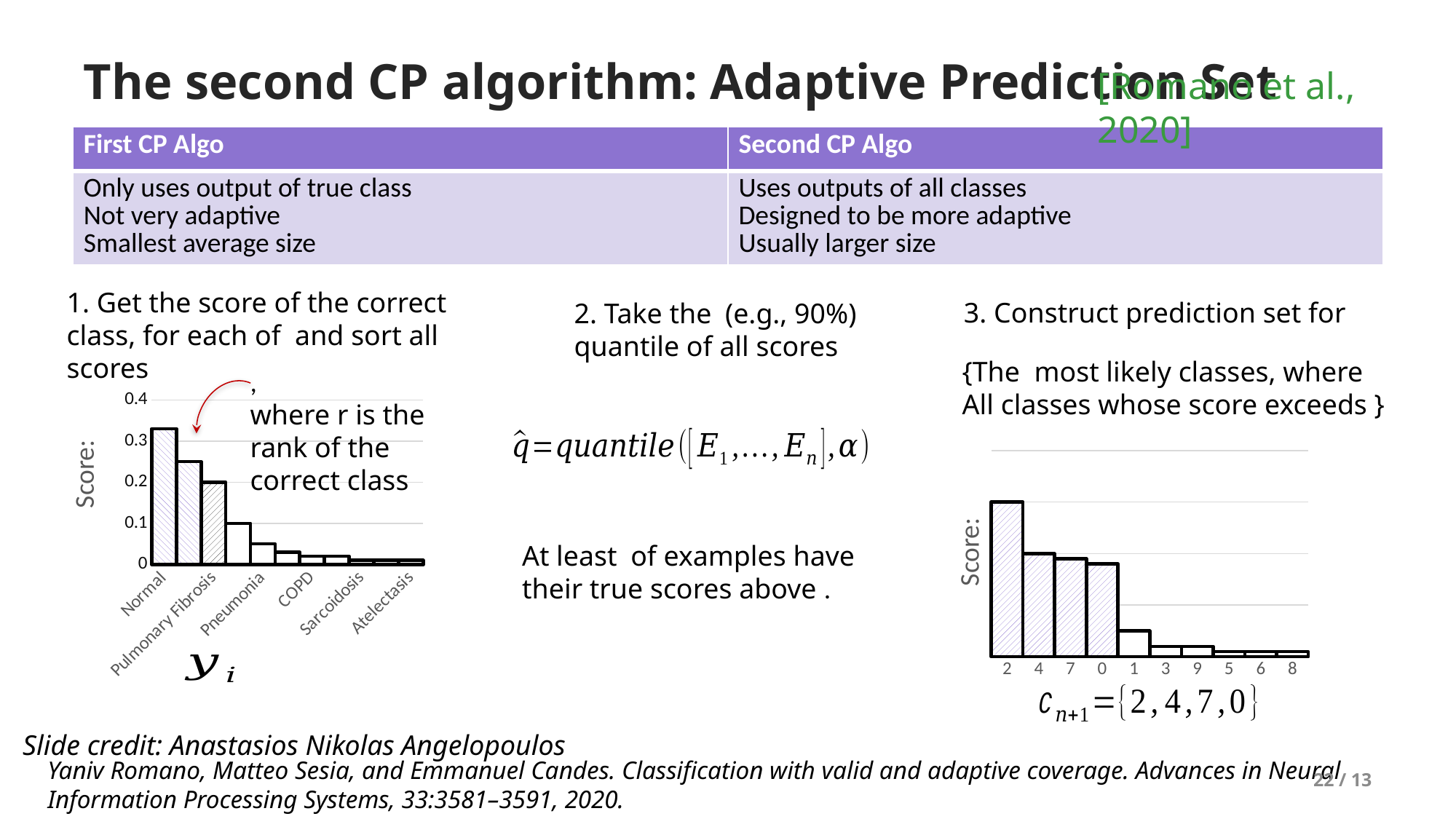
What is the highest tick value shown on the y axis of the left chart? 0.4 What kind of chart is the left chart with the Score axis and disease class labels? bar chart How many bars are plotted in the right chart (step 3)? 10 What is the label of the y axis in the left chart? Score In the left chart, is the score for Normal greater or less than 0.4? less In the left chart, is the score for Normal greater or less than 0.3? greater In the right chart (step 3), do the scores rise or fall from left to right along the x axis? fall In the right chart (step 3), which class index has the highest score? 2 How many bars are plotted in the left chart? 11 In the left chart, do the scores rise or fall from left to right along the x axis? fall In the left chart, which class has the highest score? Normal In the right chart (step 3), which has the larger score, class 0 or class 1? 0